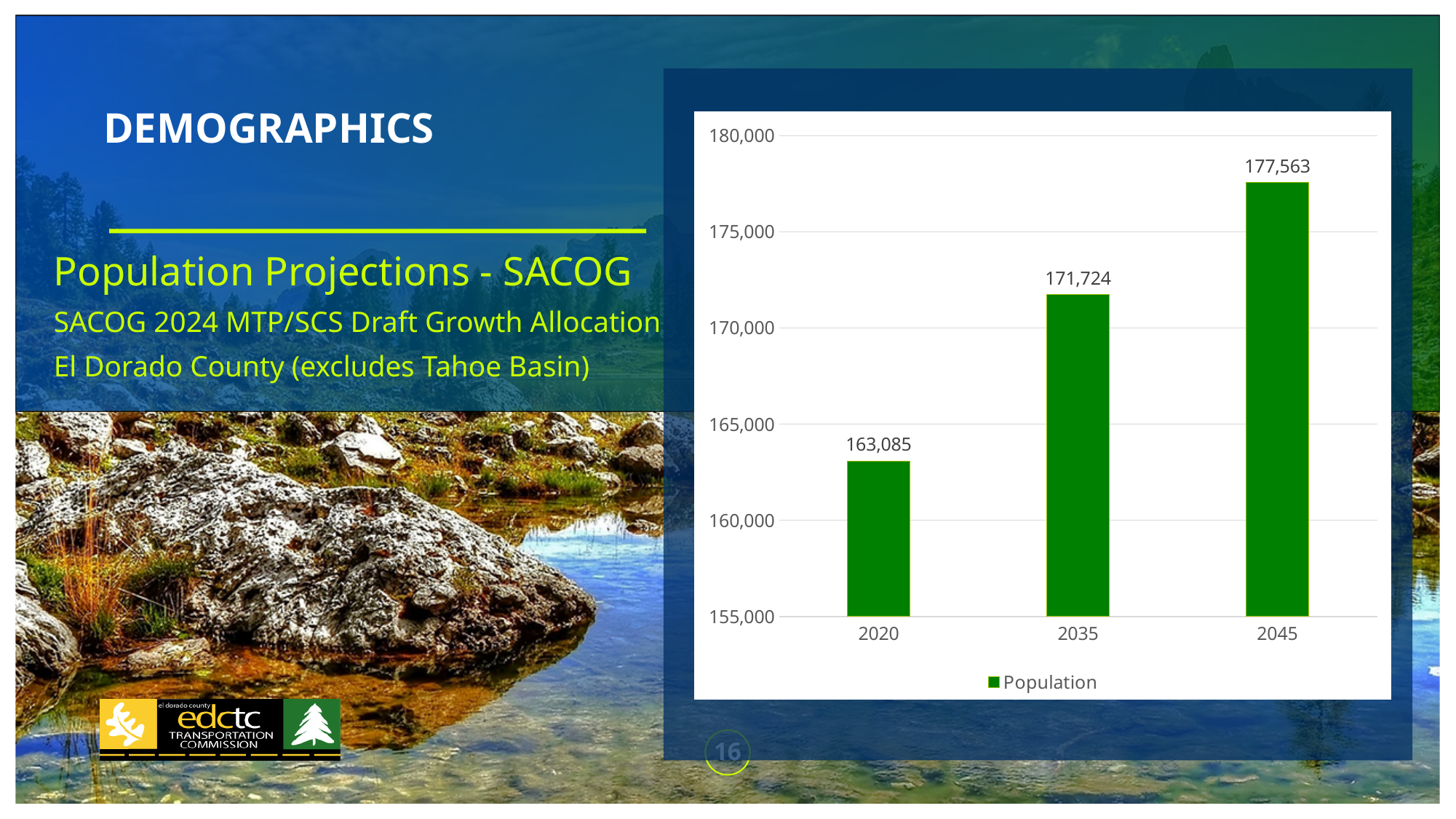
What is the projected population for 2045? 177,563 What is the difference between the population values for 2045 and 2020? 14,478 What is the population value shown for 2020? 163,085 What is the projected population for 2035? 171,724 Is the population value for 2035 greater or less than 170,000? greater Which is larger, the population value for 2035 or for 2045? 2045 What is the difference between the population values for 2035 and 2020? 8,639 Do the population values rise or fall from 2020 to 2045? Rise What kind of chart is shown on the slide? Bar chart How many years are shown on the x axis of the chart? 3 Which year has the lowest population value? 2020 Which year has the highest population value? 2045